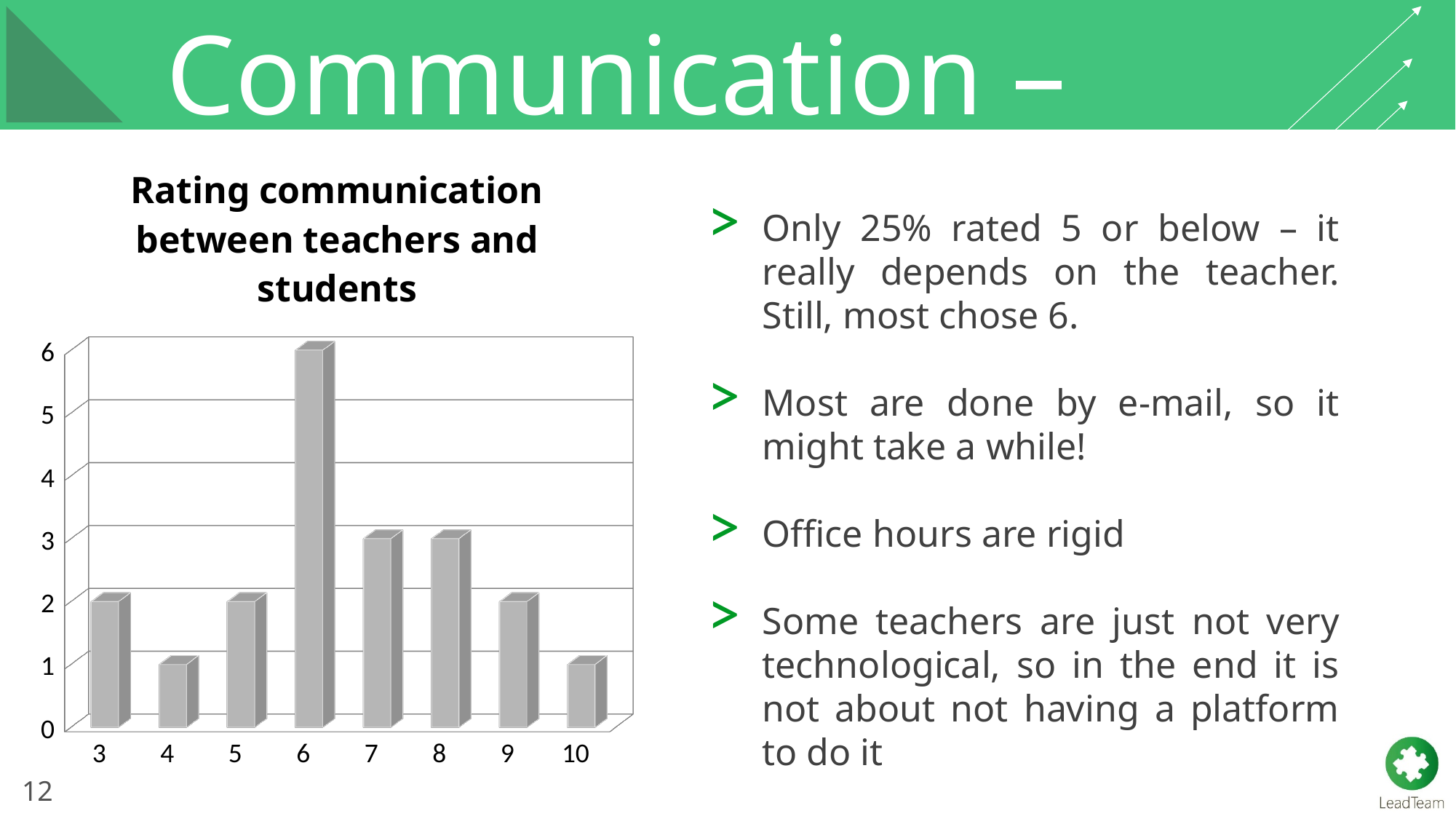
What is the title of the chart? Rating communication between teachers and students Which is larger, the value for rating 5 or the value for rating 7? Rating 7 What is the value of the bar for rating 7? 3 How many rating categories are shown on the x axis of the chart? 8 Do the values for ratings 7 and 8 have the same height? Yes What is the value of the bar for rating 6? 6 Which rating has the highest bar in the chart? 6 What is the value of the bar for rating 9? 2 What is the difference between the values for rating 6 and rating 8? 3 Is the value for rating 6 greater or less than 5? greater What kind of chart is shown on the slide? Bar chart What is the value of the bar for rating 4? 1